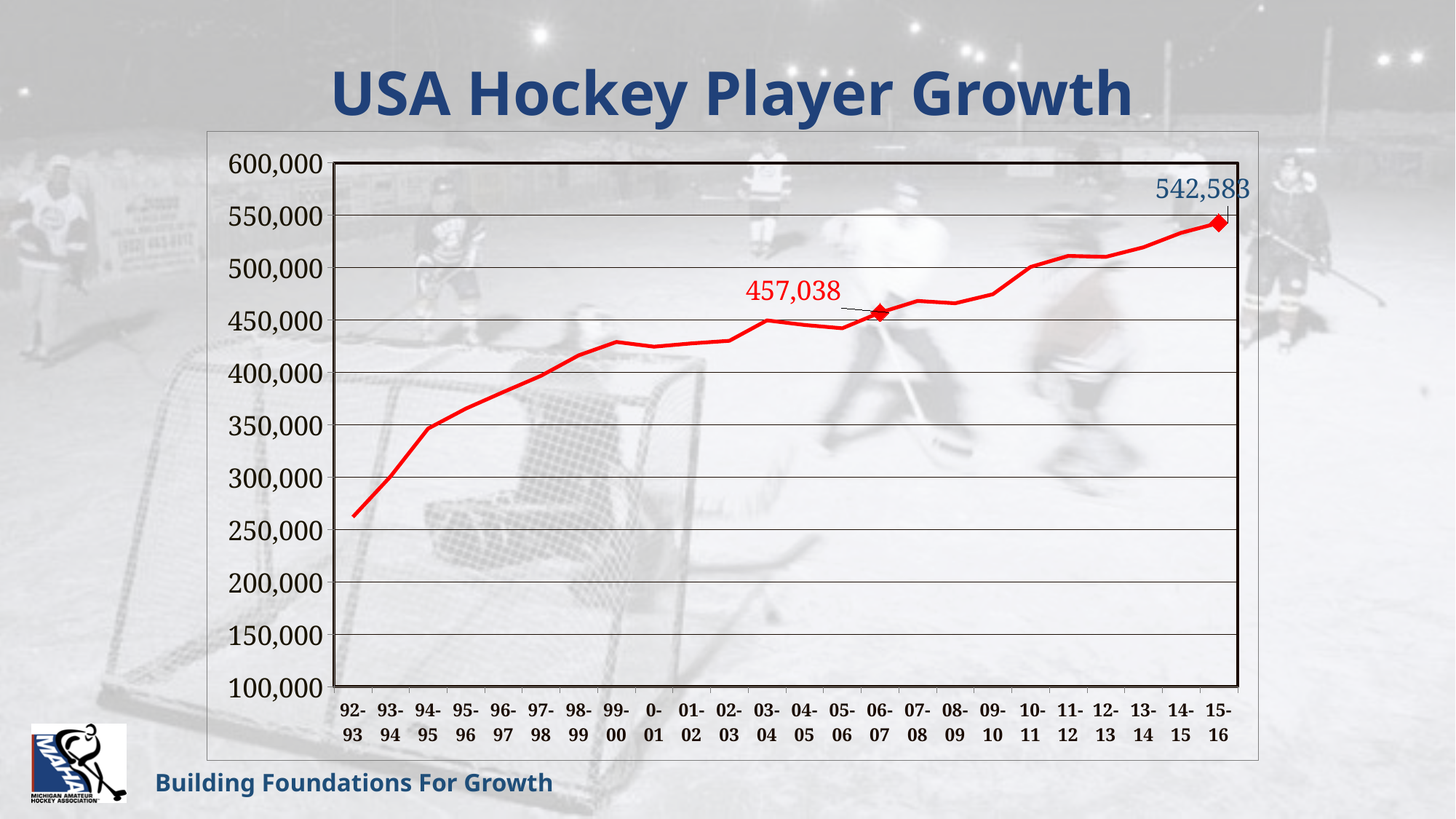
Which season has the highest value? 15-16 What is the value for the 06-07 season? 457,038 Which season has the lowest value? 92-93 What kind of chart is shown on the slide? line chart How many seasons are plotted along the x axis? 24 Is the value for 92-93 greater or less than 300,000? less Do the values generally rise or fall from 92-93 to 15-16? rise Is the value for 94-95 greater or less than 400,000? less What is the difference between the 15-16 value and the 06-07 value? 85,545 What is the value for the 15-16 season? 542,583 What is the title of the chart? USA Hockey Player Growth Which is larger, the value for 06-07 or the value for 15-16? 15-16